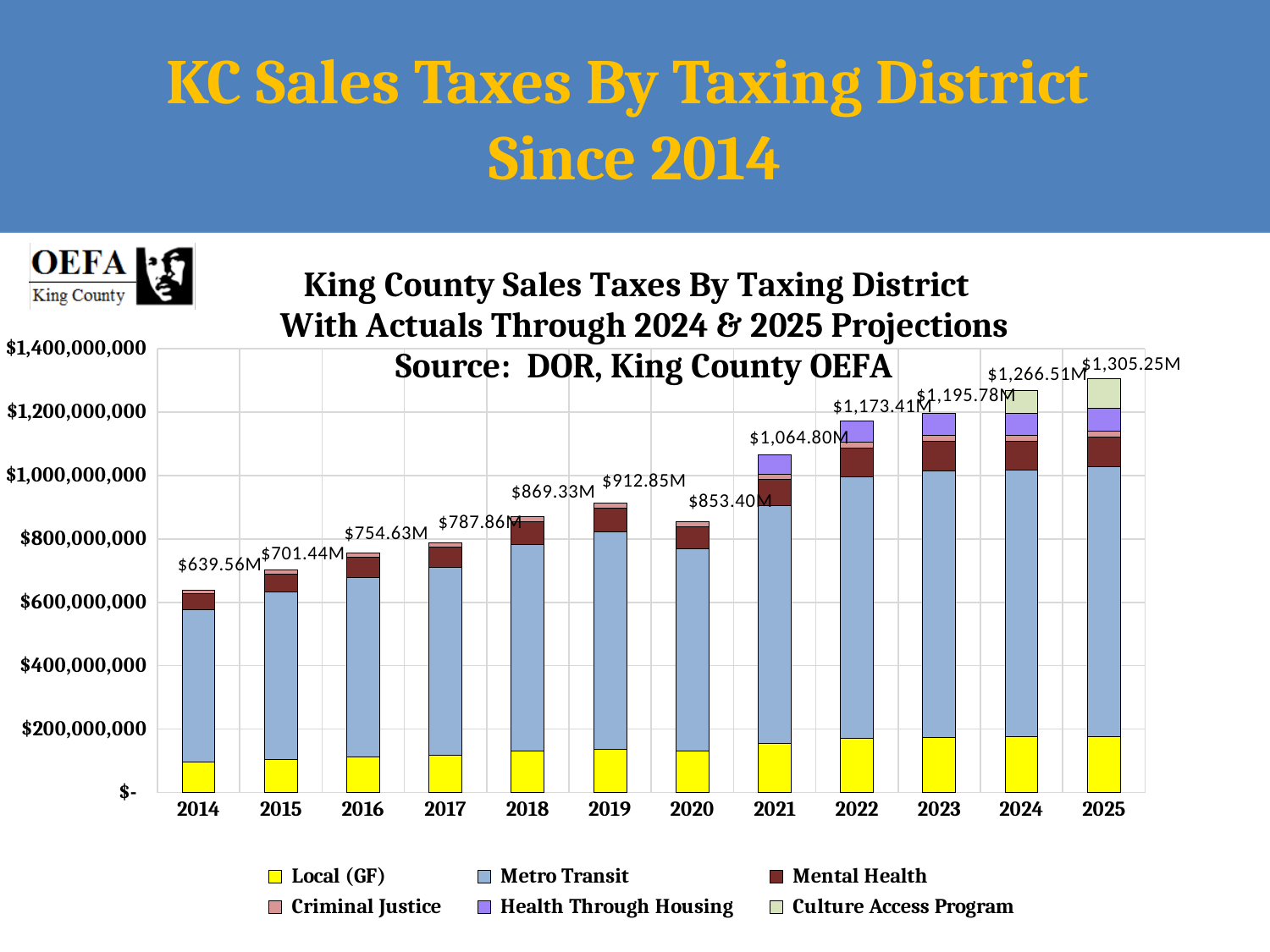
How many years are shown on the x axis? 12 What kind of chart is shown on the slide? Stacked bar chart Which year has the lowest total sales tax? 2014 Which year has a larger total, 2019 or 2020? 2019 Which year has the highest total sales tax? 2025 By how much did the total fall from 2019 to 2020? $59.45M How many series does the legend list? 6 What is the difference between the 2025 total and the 2024 total? $38.74M Is the Local (GF) value for 2014 greater or less than $200,000,000? less What is the total sales tax labeled for 2014? $639.56M What is the total sales tax labeled for 2021? $1,064.80M What is the projected total sales tax labeled for 2025? $1,305.25M